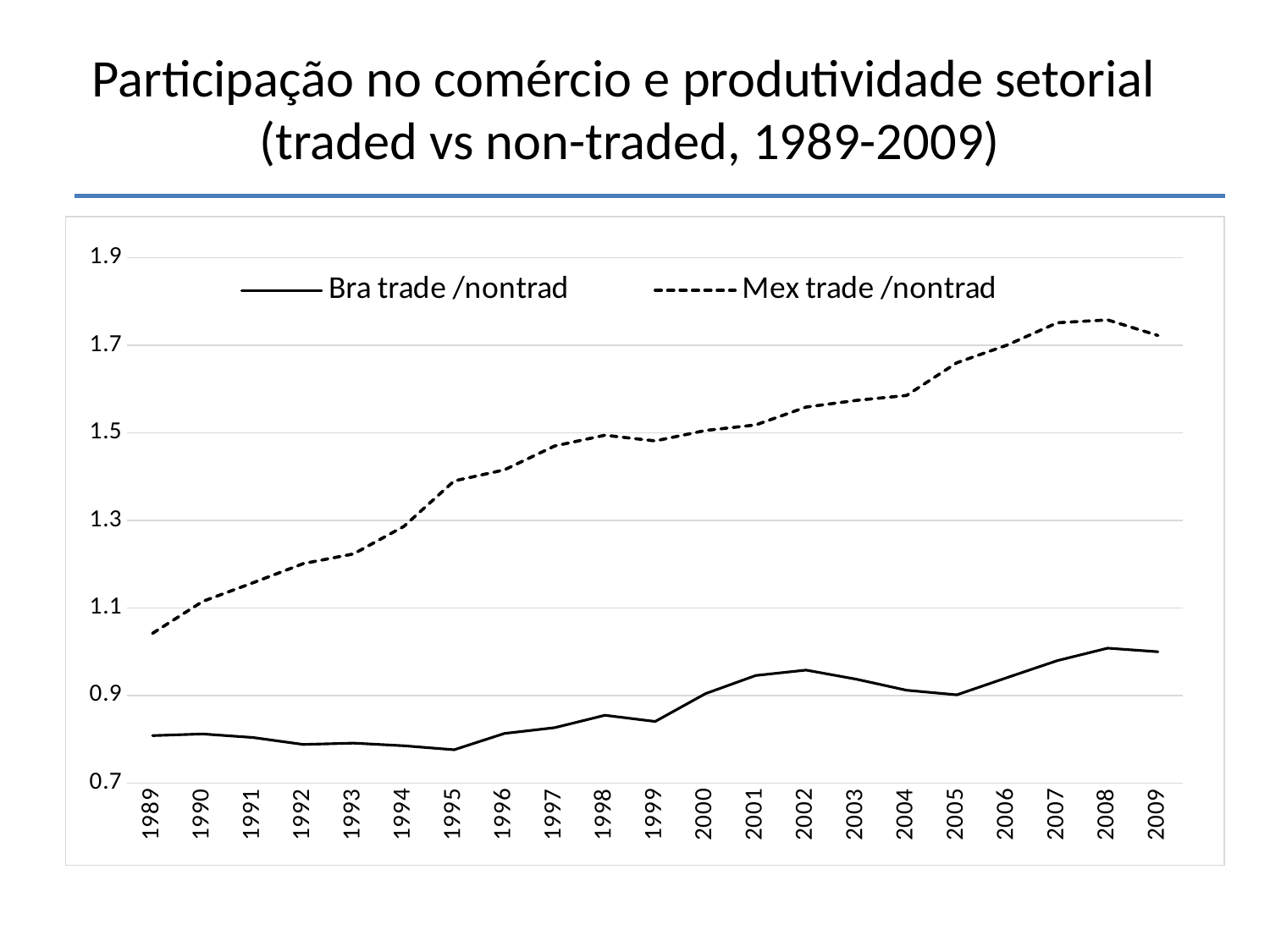
Does the Bra trade /nontrad series rise or fall from 1995 to 2008? rise Is the value for Bra trade /nontrad in 2002 greater or less than 0.9? greater Which series has the higher value in 2000, Bra trade /nontrad or Mex trade /nontrad? Mex trade /nontrad Is the value for Mex trade /nontrad in 1995 greater or less than 1.3? greater Does the Mex trade /nontrad series rise or fall overall from 1989 to 2009? rise What kind of chart is shown on the slide? line chart How many years are plotted along the x axis? 21 How many series does the legend list? 2 Is the value for Mex trade /nontrad in 2004 greater or less than 1.5? greater Which series is drawn with a dashed line? Mex trade /nontrad What is the first year shown on the x axis? 1989 In which year is the Mex trade /nontrad series at its lowest? 1989